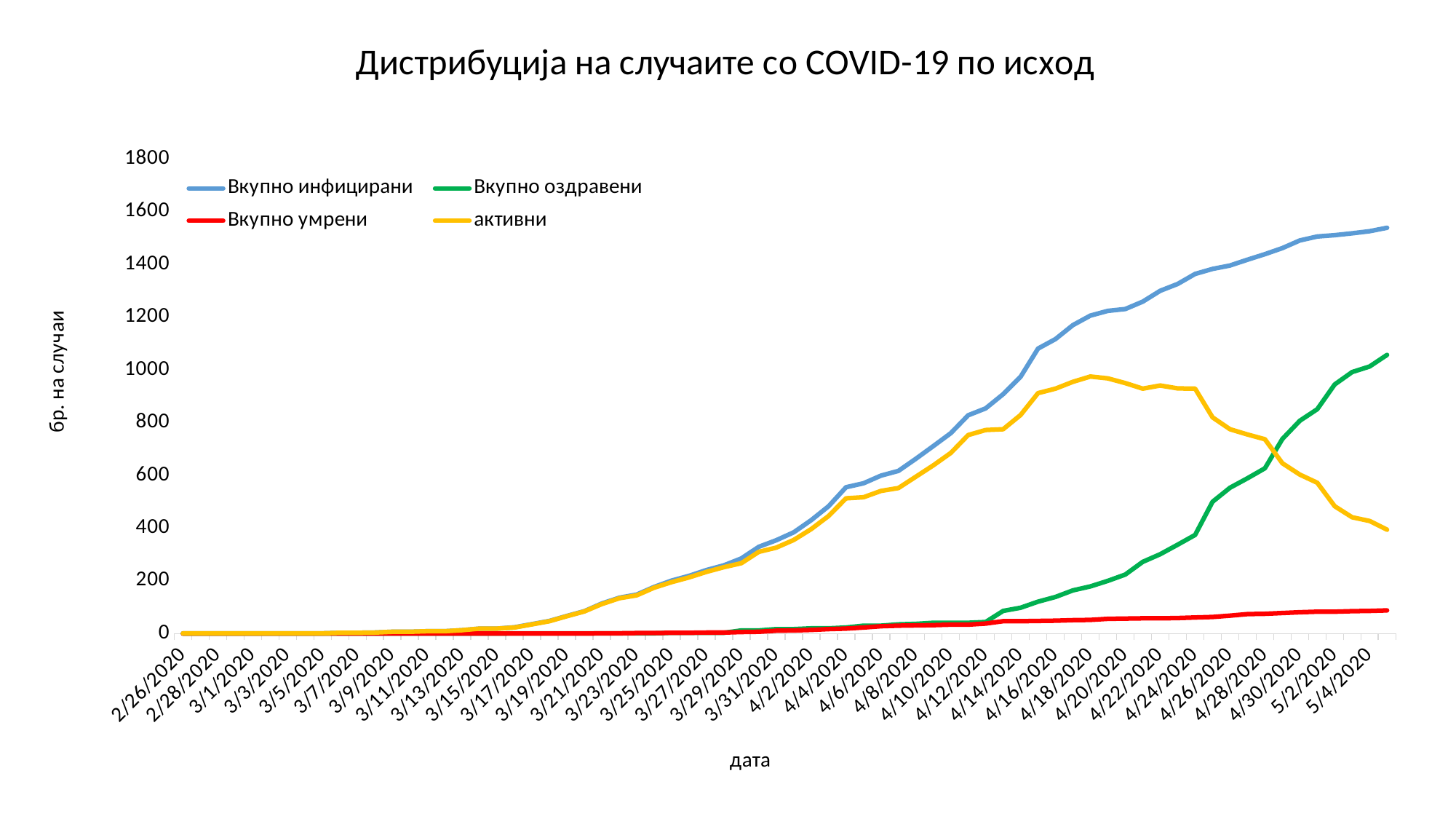
Which series has the lowest value at the end of the period (5/4/2020)? Вкупно умрени What is the label of the vertical axis? бр. на случаи Which series reaches the highest value on the chart? Вкупно инфицирани How many series does the legend list? 4 Is the value for Вкупно инфицирани on 5/4/2020 greater or less than 1400? greater On 5/4/2020, which is larger: Вкупно оздравени or активни? Вкупно оздравени What kind of chart is shown on the slide? line chart What is the title of the chart? Дистрибуција на случаите со COVID-19 по исход Is the value for Вкупно оздравени on 4/26/2020 greater or less than 600? less Does the Вкупно инфицирани series rise or fall over the period shown? rise Is the value for Вкупно умрени on 5/4/2020 greater or less than 200? less